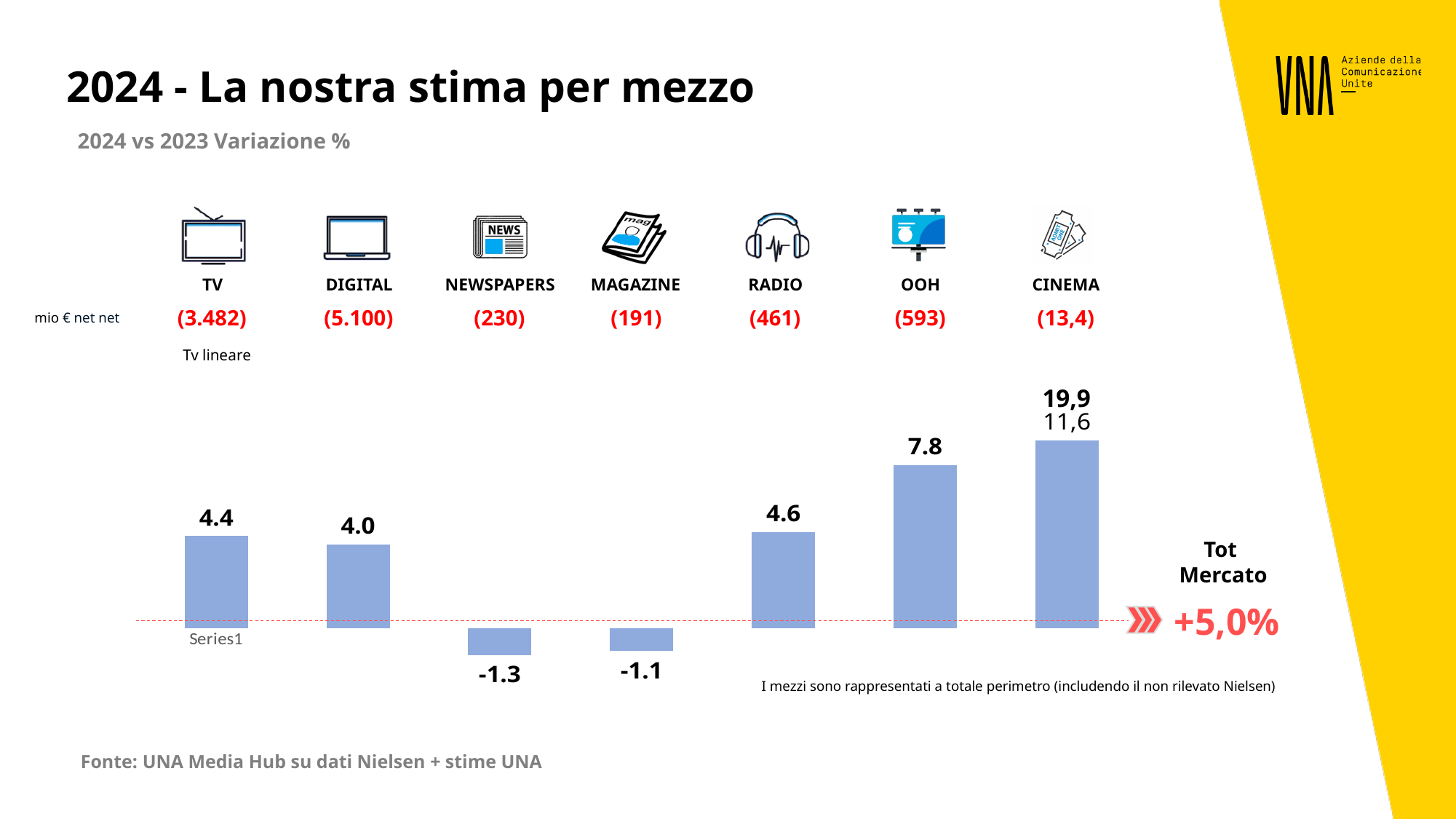
Which has the larger value, TV or DIGITAL? TV Which category has the highest value in the chart? CINEMA What is the difference between the values for OOH and RADIO? 3.2 What kind of chart is shown on the slide? bar chart What total market (Tot Mercato) variation is shown next to the chart? +5,0% What is the value shown for NEWSPAPERS in the chart? -1.3 What is the value shown for RADIO in the chart? 4.6 How many media categories are plotted in the chart? 7 Which category has the lowest value in the chart? NEWSPAPERS How many categories in the chart have a negative value? 2 What is the value shown for OOH in the chart? 7.8 What is the 2024 vs 2023 variation % shown for TV? 4.4